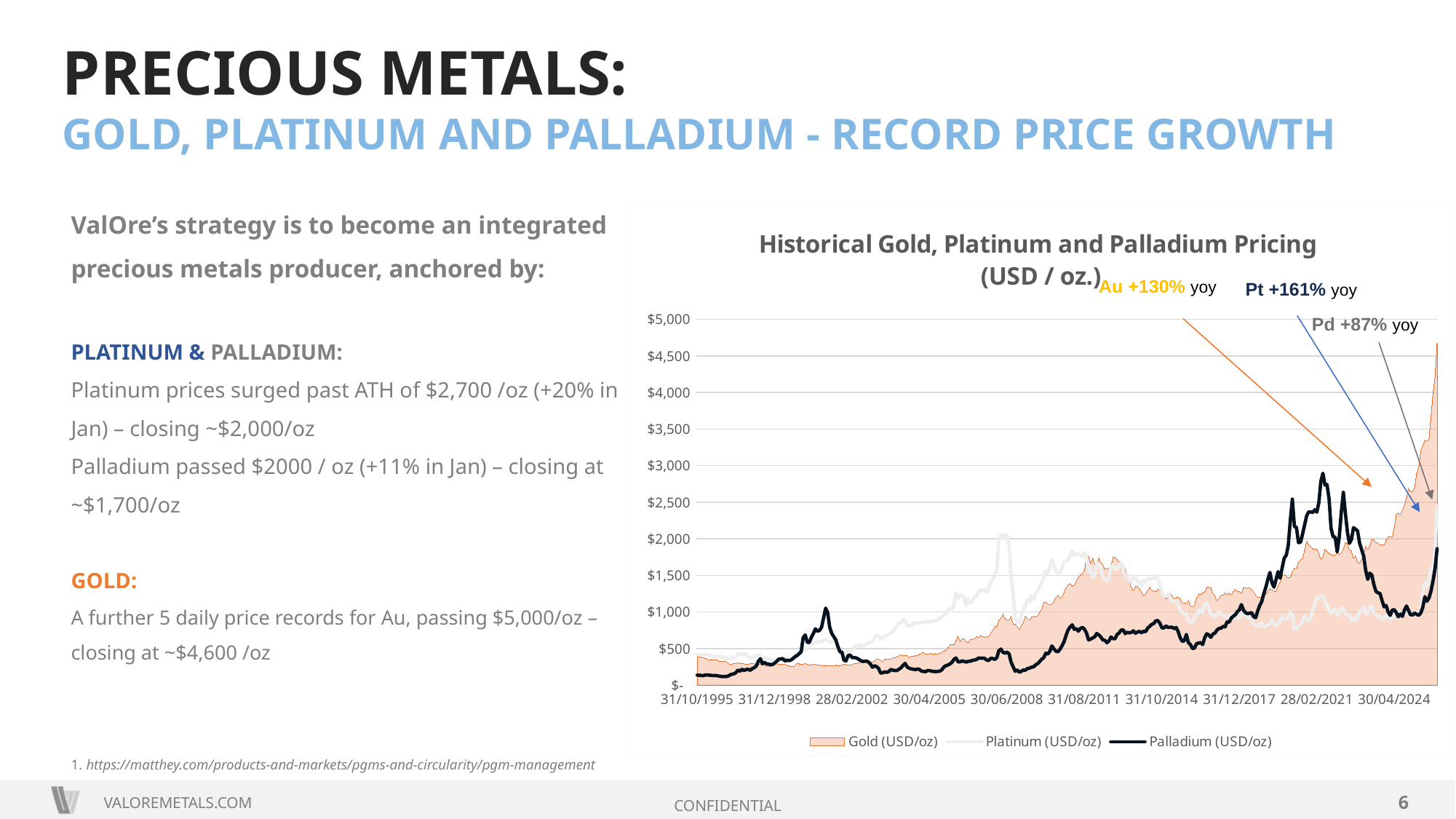
What is the title of the chart? Historical Gold, Platinum and Palladium Pricing (USD / oz.) Which metal has the highest annotated year-over-year price growth? Pt (platinum) At the right-hand end of the chart, which is higher: the gold price or the palladium price? Gold What year-over-year change is annotated for Au (gold) on the chart? +130% What year-over-year change is annotated for Pt (platinum) on the chart? +161% What year-over-year change is annotated for Pd (palladium) on the chart? +87% Is the peak palladium price around 2021-2022 greater or less than $2,500? greater What is the overall trend of the gold price from 1995 to the end of the chart? Rising Which metal has the lowest annotated year-over-year price growth? Pd (palladium) Which series is drawn as a shaded area in the chart? Gold (USD/oz) Is the gold price at the right-hand end of the chart greater or less than $4,000? greater How many series does the chart legend list? 3